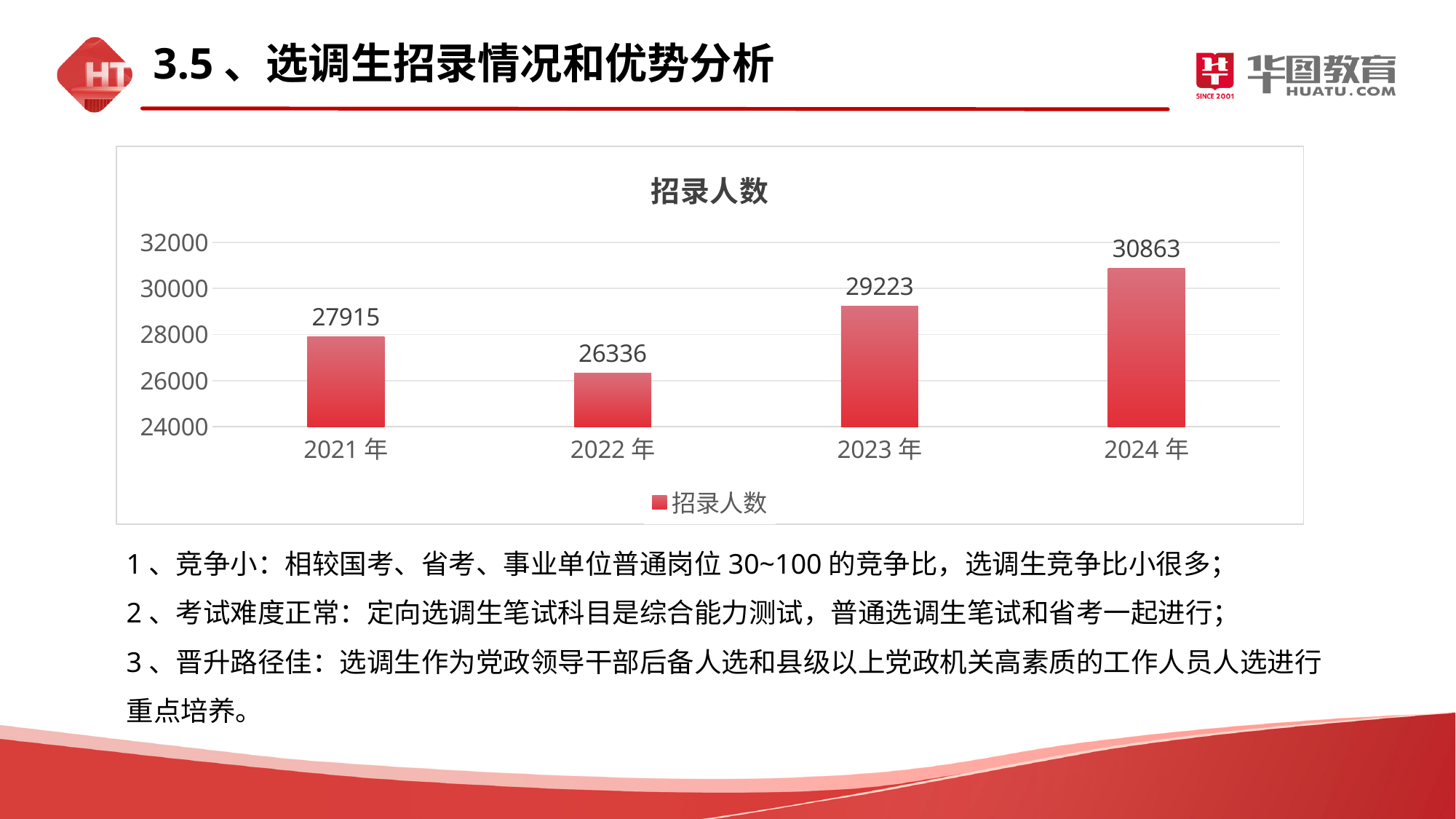
What is the value for 2024 年? 30863 What is the value for 2022 年? 26336 What is the value for 2021 年? 27915 What is the difference between the values for 2021 年 and 2022 年? 1579 Which year has the lowest value? 2022 年 What kind of chart is this? bar chart Which is larger, the value for 2021 年 or the value for 2023 年? 2023 年 How many years are shown on the x axis? 4 What is the title of the chart? 招录人数 Which year has the highest value? 2024 年 What is the value for 2023 年? 29223 What is the difference between the values for 2024 年 and 2023 年? 1640